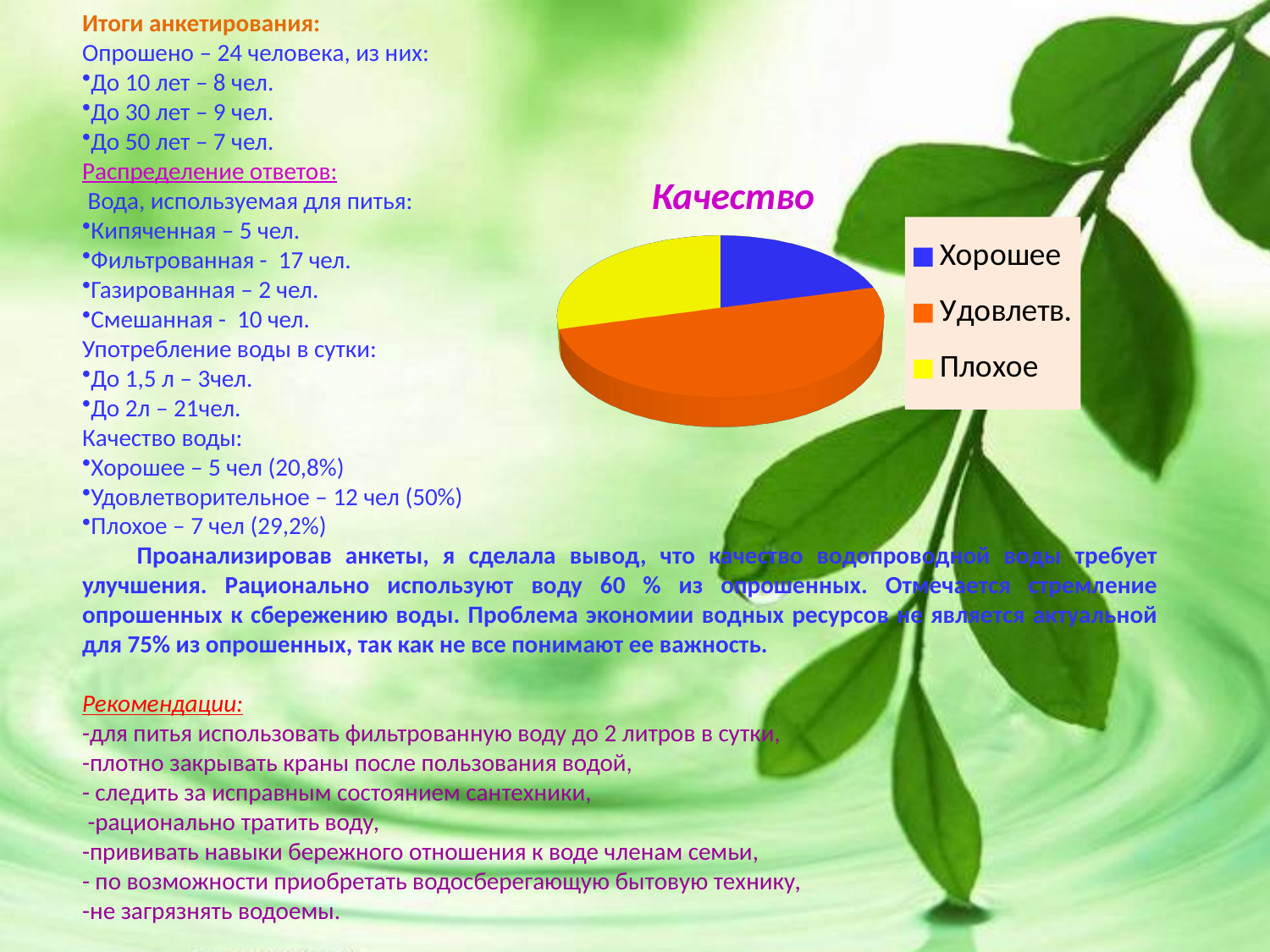
Which category has the smallest slice in the pie chart? Хорошее Which colour represents Плохое in the pie chart? yellow How many entries does the legend of the pie chart list? 3 How many slices does the pie chart have? 3 Which slice is larger in the pie chart, Удовлетв. or Плохое? Удовлетв. Which category has the largest slice in the pie chart? Удовлетв. What kind of chart is shown on the slide? pie chart Which slice is larger in the pie chart, Хорошее or Плохое? Плохое What is the title of the pie chart? Качество